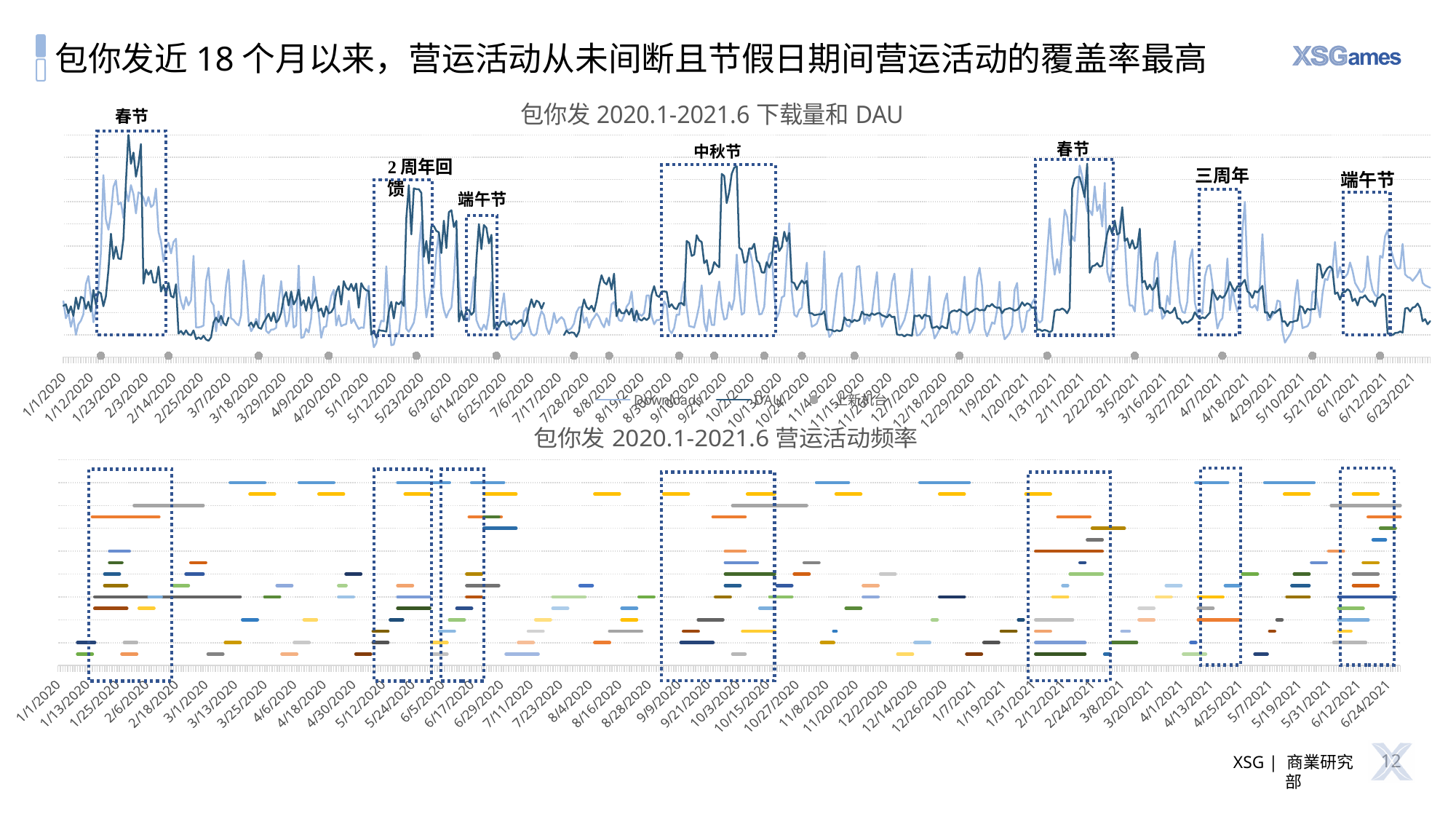
In the top chart, how many lines are plotted? 2 What is the title of the top chart on the slide? 包你发 2020.1-2021.6 下载量和 DAU In the top chart, which holiday label is attached to the first (leftmost) dotted box? 春节 In the top chart, in which annotated box does the dark blue line reach its highest peak? 春节 (the first one, early 2020) In the top chart, which label is attached to the last (rightmost) dotted box? 端午节 In the top chart, what is the last date shown on the x axis? 6/23/2021 In the top chart, how many dotted highlight boxes are drawn over the lines? 7 In the bottom chart, what is the last date shown on the x axis? 6/24/2021 What kind of chart is the top chart titled 包你发 2020.1-2021.6 下载量和 DAU? line chart What is the title of the bottom chart on the slide? 包你发 2020.1-2021.6 营运活动频率 In the top chart, which annotated box lies between 2 周年回馈 and 中秋节? 端午节 In the top chart, what is the first date shown on the x axis? 1/1/2020